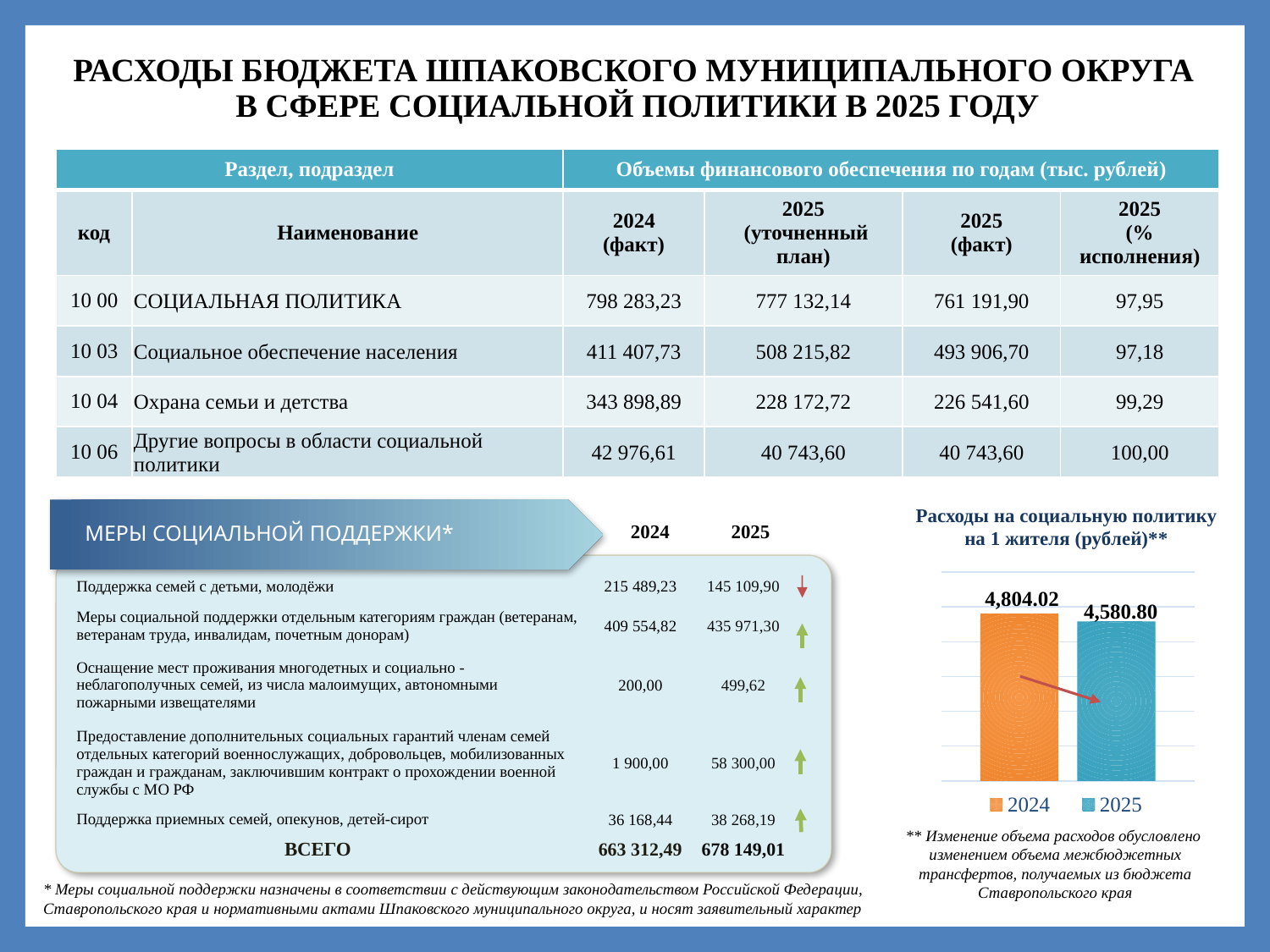
What type of chart is shown under the title "Расходы на социальную политику на 1 жителя (рублей)**"? bar chart In the chart "Расходы на социальную политику на 1 жителя (рублей)**", what colour is the bar for 2025? teal (blue) In the chart "Расходы на социальную политику на 1 жителя (рублей)**", do the values rise or fall from 2024 to 2025? fall How many entries does the legend of the chart "Расходы на социальную политику на 1 жителя (рублей)**" list? 2 How many bars are plotted in the chart "Расходы на социальную политику на 1 жителя (рублей)**"? 2 In the chart "Расходы на социальную политику на 1 жителя (рублей)**", which year has the lower value? 2025 In the chart "Расходы на социальную политику на 1 жителя (рублей)**", what colour is the bar for 2024? orange In the chart "Расходы на социальную политику на 1 жителя (рублей)**", is the value for 2025 larger or smaller than the value for 2024? smaller In the chart "Расходы на социальную политику на 1 жителя (рублей)**", which year has the higher value? 2024 In the chart "Расходы на социальную политику на 1 жителя (рублей)**", what is the difference between the 2024 and 2025 values? 223.22 In the chart "Расходы на социальную политику на 1 жителя (рублей)**", what is the value for 2025? 4,580.80 In the chart "Расходы на социальную политику на 1 жителя (рублей)**", what is the value for 2024? 4,804.02